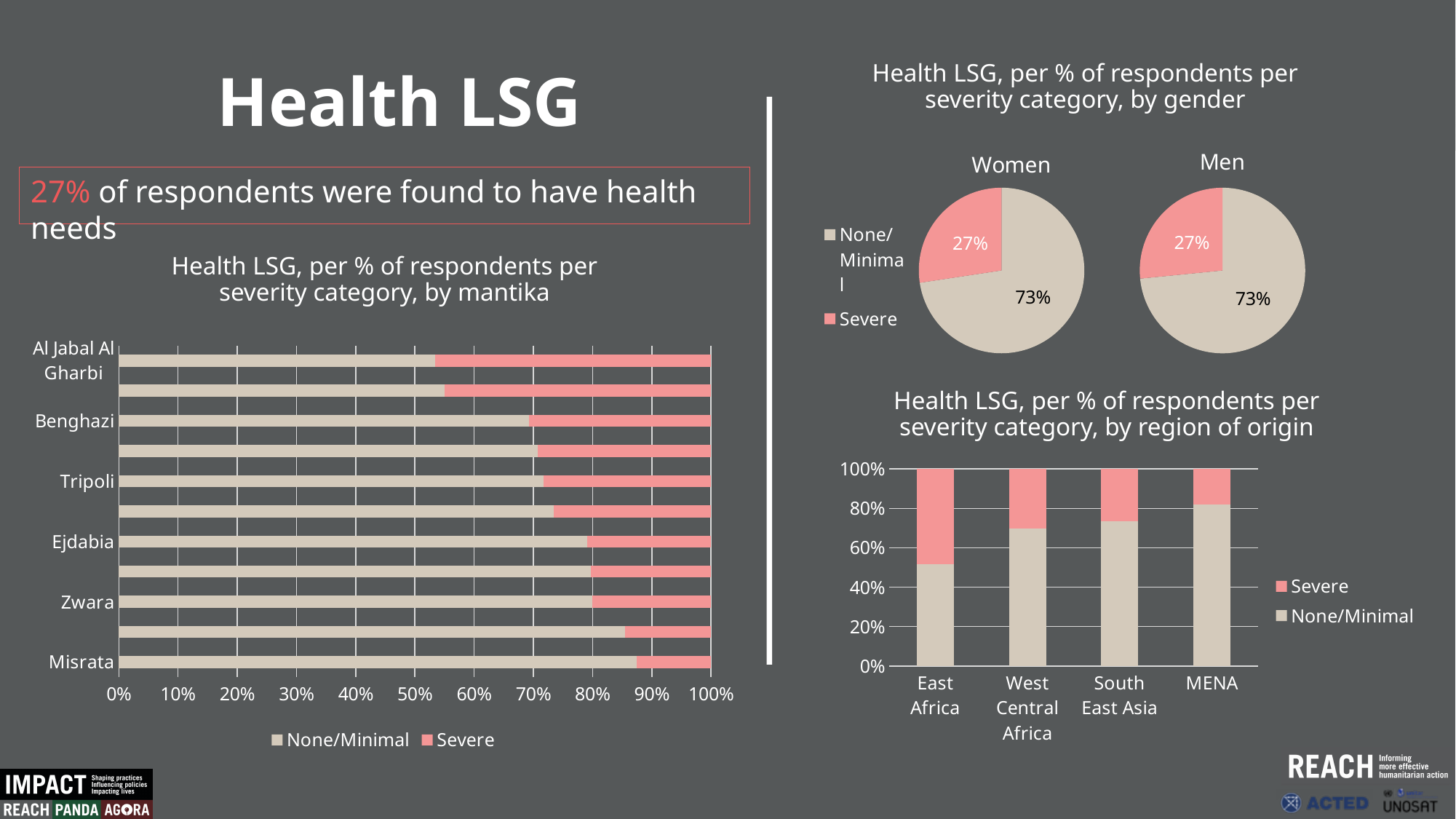
In the chart by mantika, is the None/Minimal value for Al Jabal Al Gharbi greater or less than 60%? less In the chart by region of origin, is the None/Minimal value for East Africa greater or less than 60%? less In the chart by mantika, which has the larger None/Minimal share, Misrata or Benghazi? Misrata In the pie chart for Women, what percentage of respondents are in the Severe category? 27% In the gender pie charts, is the Severe share for Men larger than, smaller than, or equal to the Severe share for Women? equal In the chart by region of origin, which region has the largest Severe share? East Africa In the chart by region of origin, how many regions are shown on the x axis? 4 In the pie chart for Men, what percentage of respondents are in the None/Minimal category? 73% In the chart by mantika, is the None/Minimal value for Misrata greater or less than 80%? greater In the gender pie charts, what is the difference between the None/Minimal share and the Severe share for Women? 46% What type of chart is used for the Health LSG by mantika data? Stacked bar chart In the chart by region of origin, which region has the highest None/Minimal share? MENA